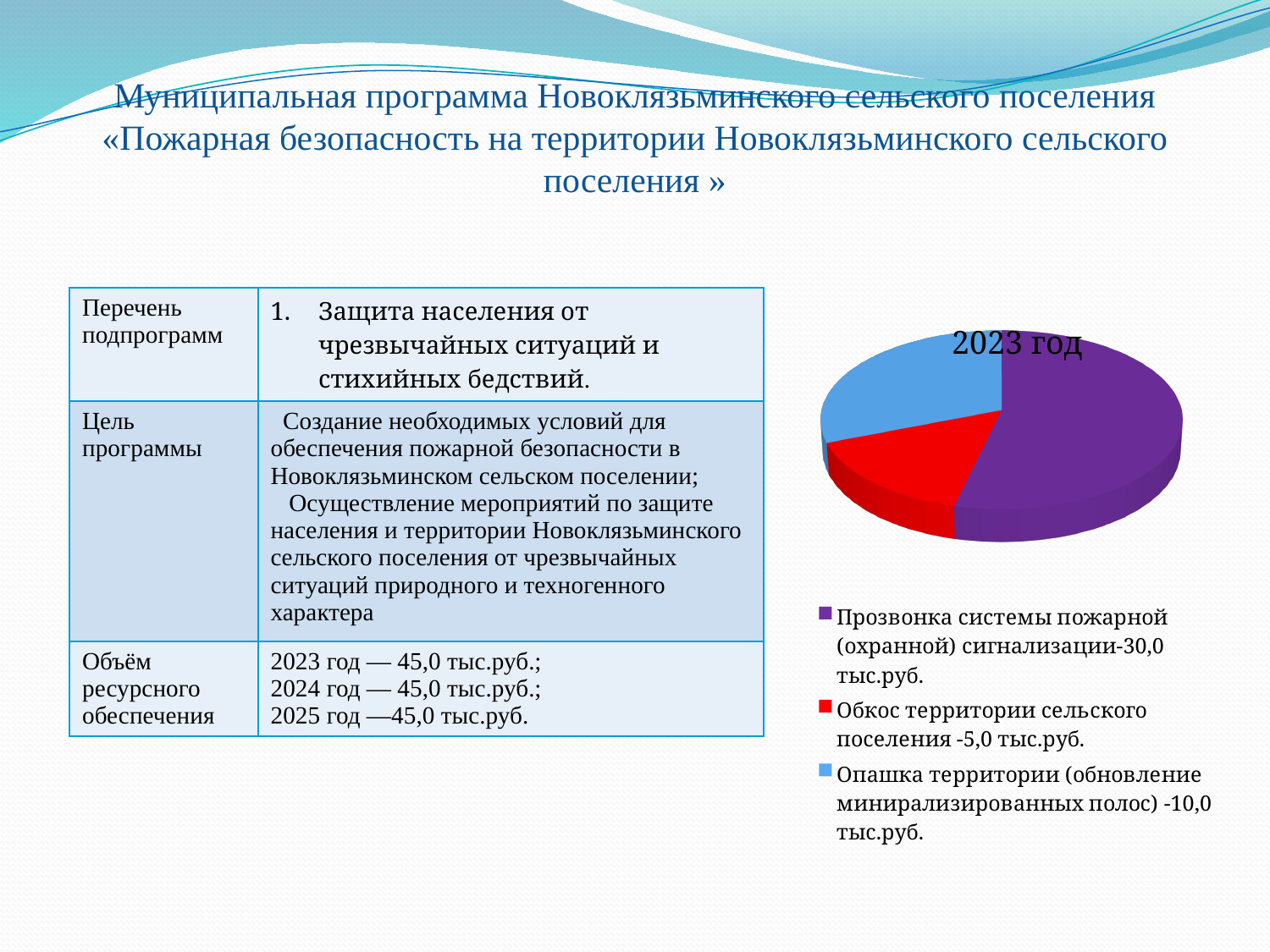
What is the value for Прозвонка системы пожарной (охранной) сигнализации in the pie chart? 30,0 тыс.руб. What colour is the slice for Обкос территории сельского поселения in the pie chart? Red What is the value for Опашка территории (обновление минирализированных полос) in the pie chart? 10,0 тыс.руб. How many slices does the pie chart have? 3 What is the value for Обкос территории сельского поселения in the pie chart? 5,0 тыс.руб. Which category has the smallest slice in the pie chart? Обкос территории сельского поселения How many entries does the legend of the pie chart list? 3 Which category has the largest slice in the pie chart? Прозвонка системы пожарной (охранной) сигнализации Which is larger: the value for Опашка территории (обновление минирализированных полос) or the value for Обкос территории сельского поселения? Опашка территории (обновление минирализированных полос) What is the difference between the value for Прозвонка системы пожарной (охранной) сигнализации and the value for Опашка территории (обновление минирализированных полос)? 20,0 тыс.руб. What is the title of the pie chart? 2023 год What kind of chart is shown on the slide? Pie chart